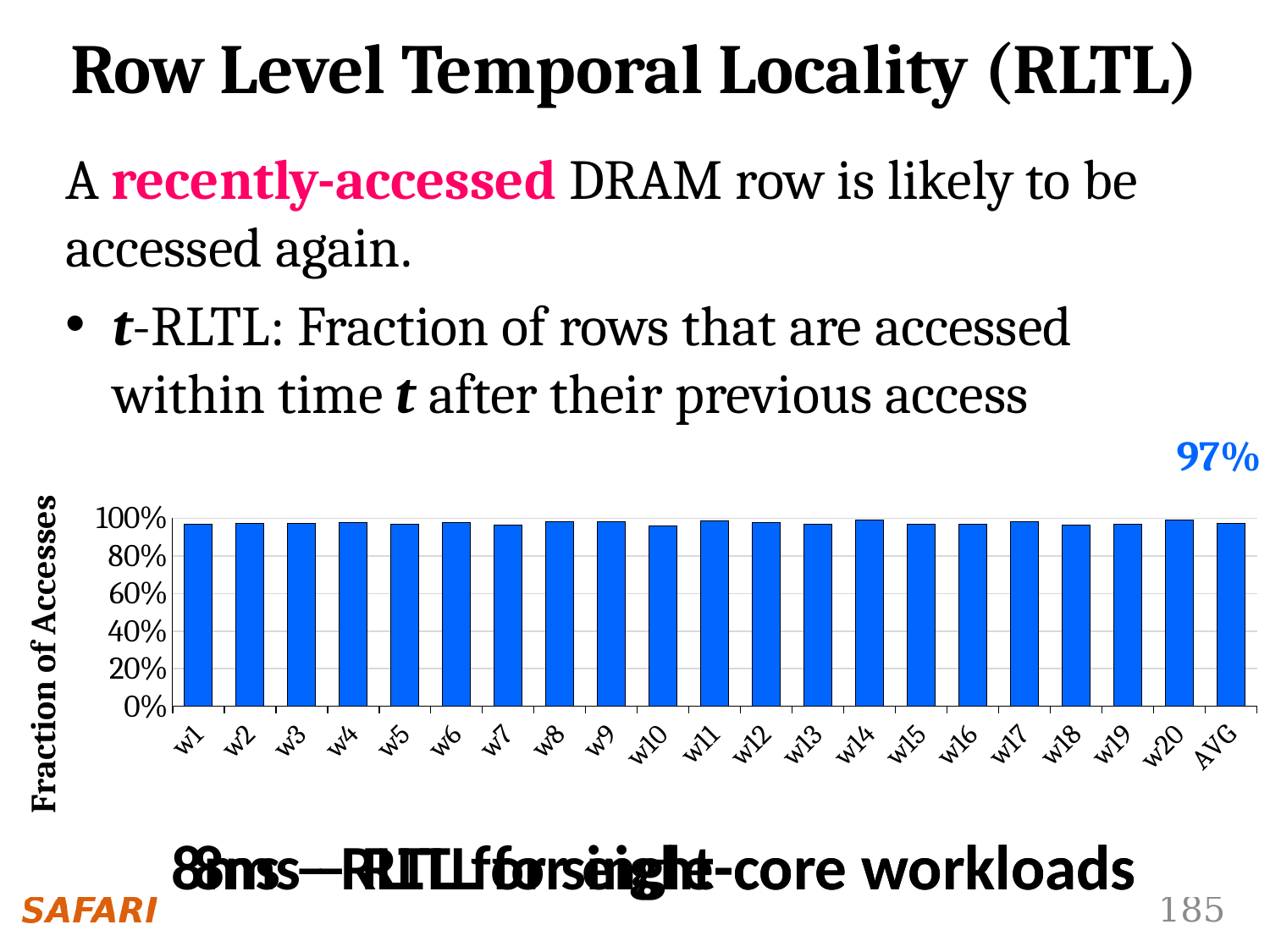
What is the label of the last category on the x axis? AVG What is the highest tick value shown on the y axis? 100% Is the value for w10 greater or less than 60%? greater Is the value for w20 greater or less than 20%? greater How many categories are shown along the x axis of the chart? 21 How many data series are plotted in the chart? 1 What kind of chart is shown on the slide? bar chart Is the value for AVG greater or less than 40%? greater What is the label of the y axis of the chart? Fraction of Accesses Do the bar values rise, fall, or stay roughly flat from w1 to w20? roughly flat What value is annotated for the AVG bar on the chart? 97%